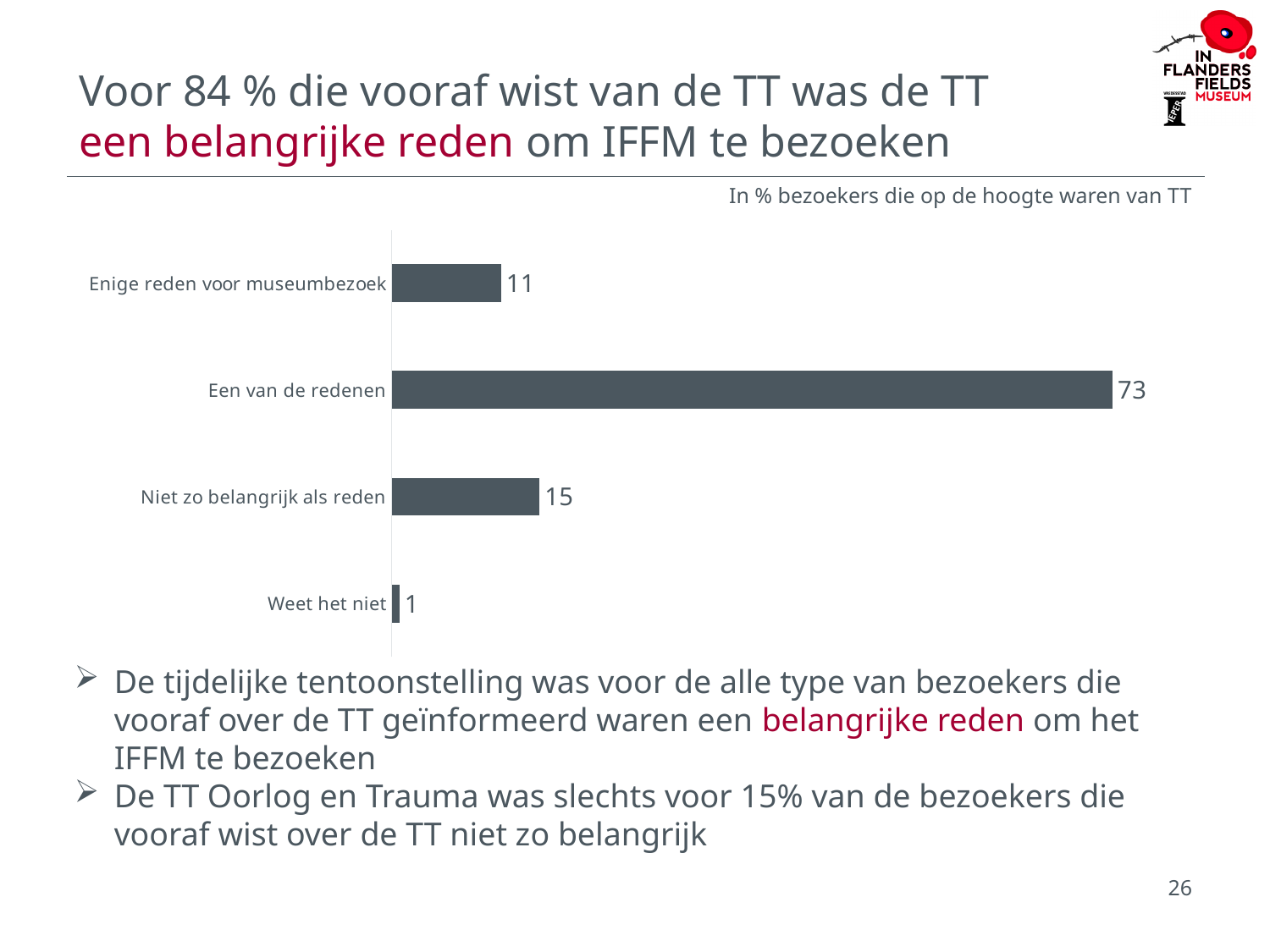
What is the difference between the values for "Niet zo belangrijk als reden" and "Enige reden voor museumbezoek"? 4 How many categories are shown in the chart? 4 Which category has the lowest value? Weet het niet What is the value for "Enige reden voor museumbezoek"? 11 What is the total of the values for "Enige reden voor museumbezoek" and "Een van de redenen"? 84 Which is larger: the value for "Enige reden voor museumbezoek" or the value for "Niet zo belangrijk als reden"? Niet zo belangrijk als reden Which category has the highest value? Een van de redenen What kind of chart is shown on the slide? Bar chart What is the value for "Weet het niet"? 1 What is the difference between the values for "Een van de redenen" and "Niet zo belangrijk als reden"? 58 What is the value for "Een van de redenen"? 73 What is the value for "Niet zo belangrijk als reden"? 15